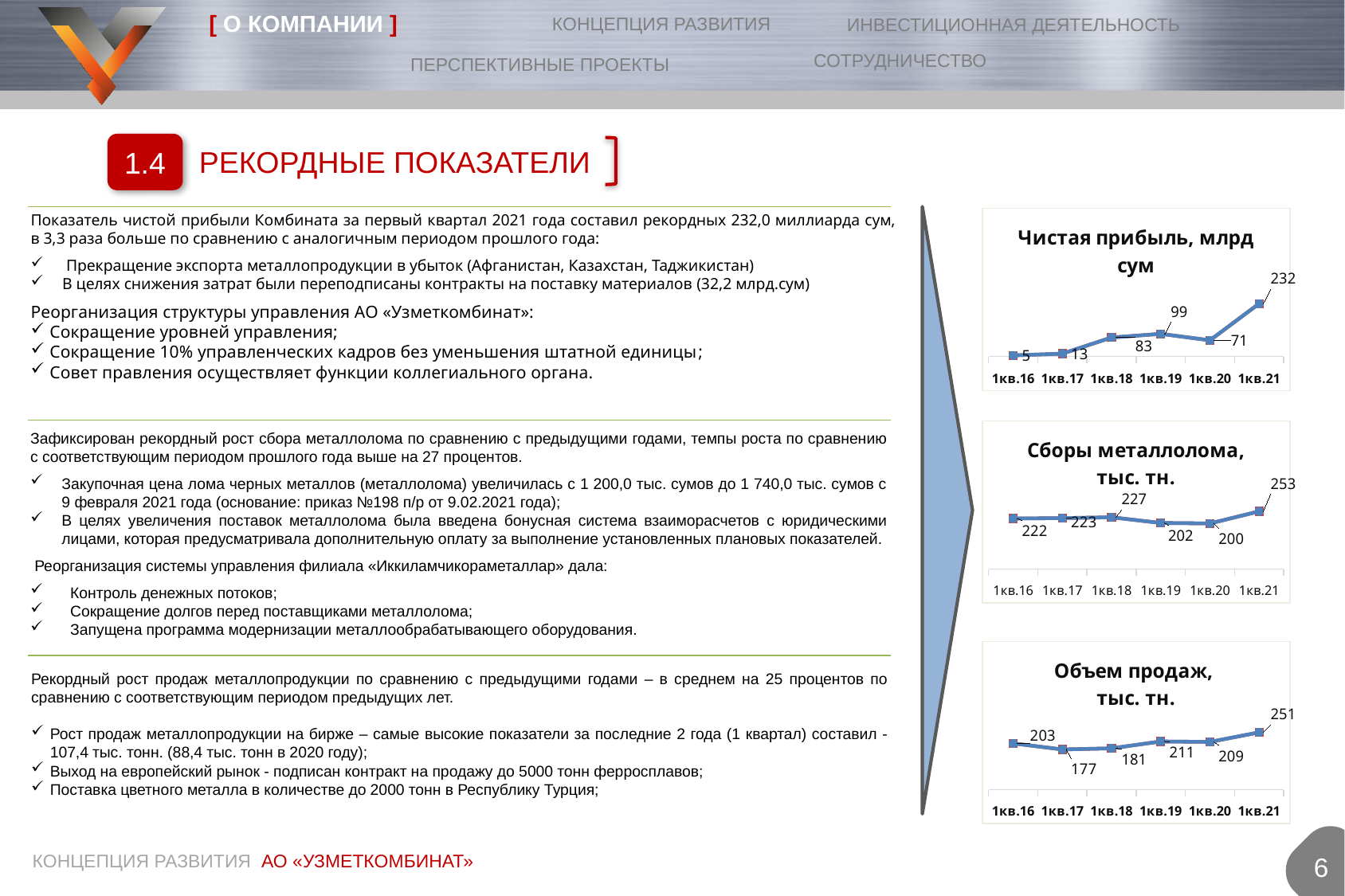
What type of chart is the chart titled "Объем продаж, тыс. тн."? Line chart In the chart titled "Чистая прибыль, млрд сум", which quarter has the lowest value? 1кв.16 In the chart titled "Чистая прибыль, млрд сум", what is the value for 1кв.21? 232 In the chart titled "Чистая прибыль, млрд сум", what is the value for 1кв.18? 83 In the chart titled "Объем продаж, тыс. тн.", what is the value for 1кв.17? 177 In the chart titled "Сборы металлолома, тыс. тн.", which quarter has the highest value? 1кв.21 In the chart titled "Объем продаж, тыс. тн.", what is the difference between the values for 1кв.21 and 1кв.20? 42 In the chart titled "Объем продаж, тыс. тн.", which is larger, the value for 1кв.19 or the value for 1кв.16? 1кв.19 In the chart titled "Чистая прибыль, млрд сум", what is the difference between the values for 1кв.21 and 1кв.20? 161 In the chart titled "Объем продаж, тыс. тн.", which quarter has the lowest value? 1кв.17 In the chart titled "Сборы металлолома, тыс. тн.", how many quarters are plotted? 6 In the chart titled "Сборы металлолома, тыс. тн.", what is the value for 1кв.19? 202